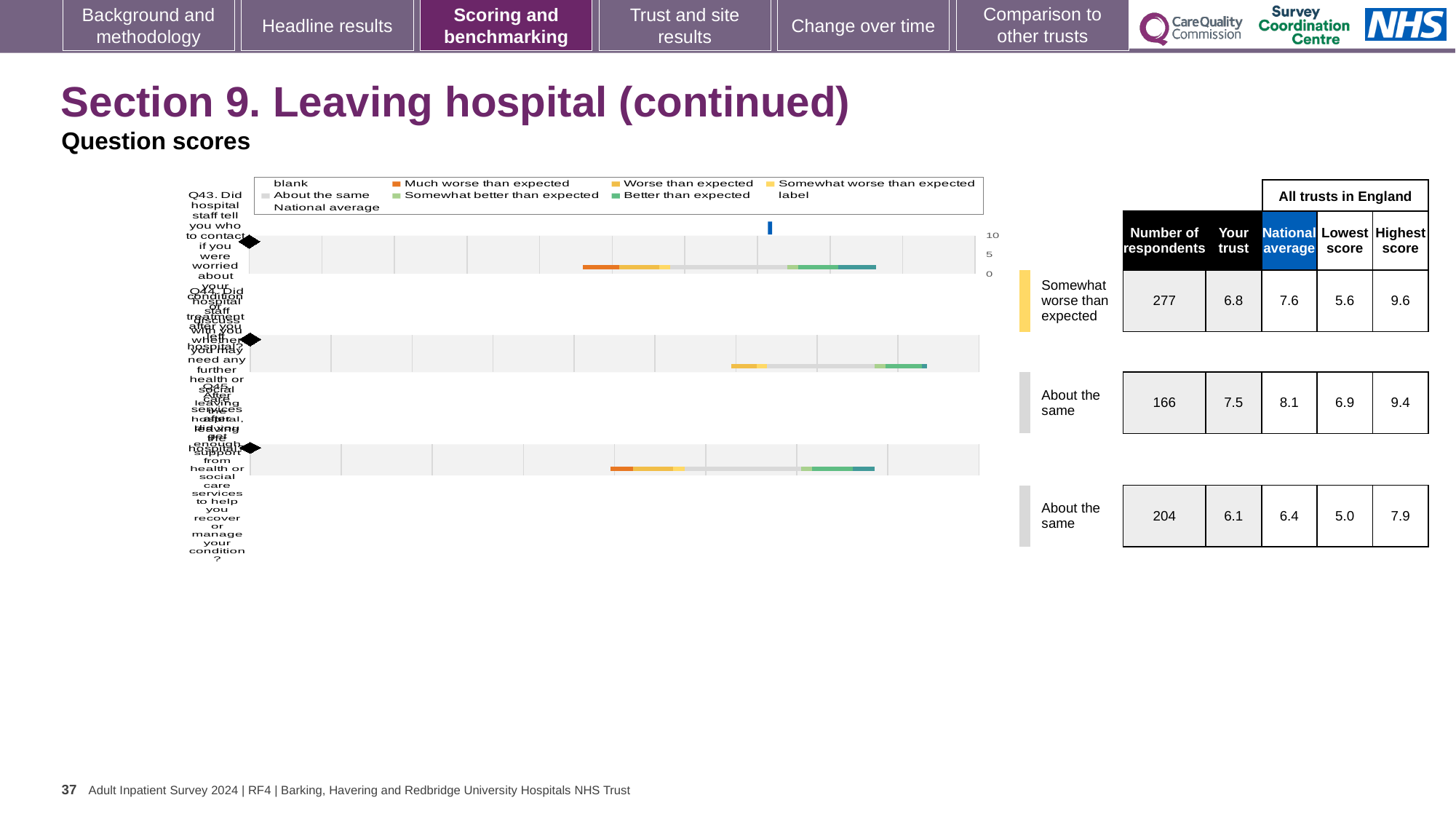
What is the highest score among all trusts in England for the third row of the table? 7.9 What benchmark category is shown for the first row (Q43)? Somewhat worse than expected What is the 'Your trust' score for Q43 (the first row of the table)? 6.8 For Q43 (the first row), which is larger: the trust's score or the national average? National average What is the national average score for Q43 (the first row of the table)? 7.6 Which row of the table has the highest 'Your trust' score? The second row (7.5) According to the table, how many respondents answered Q43 (the first row)? 277 For the second row of the table, what is the difference between the highest score and the lowest score? 2.5 Which row of the table has the lowest 'Lowest score' value? The third row (5.0) How many question bars are plotted in the chart? 3 What kind of chart is shown on the slide? bar chart For Q43 (the first row), how much higher is the national average than the trust's score? 0.8